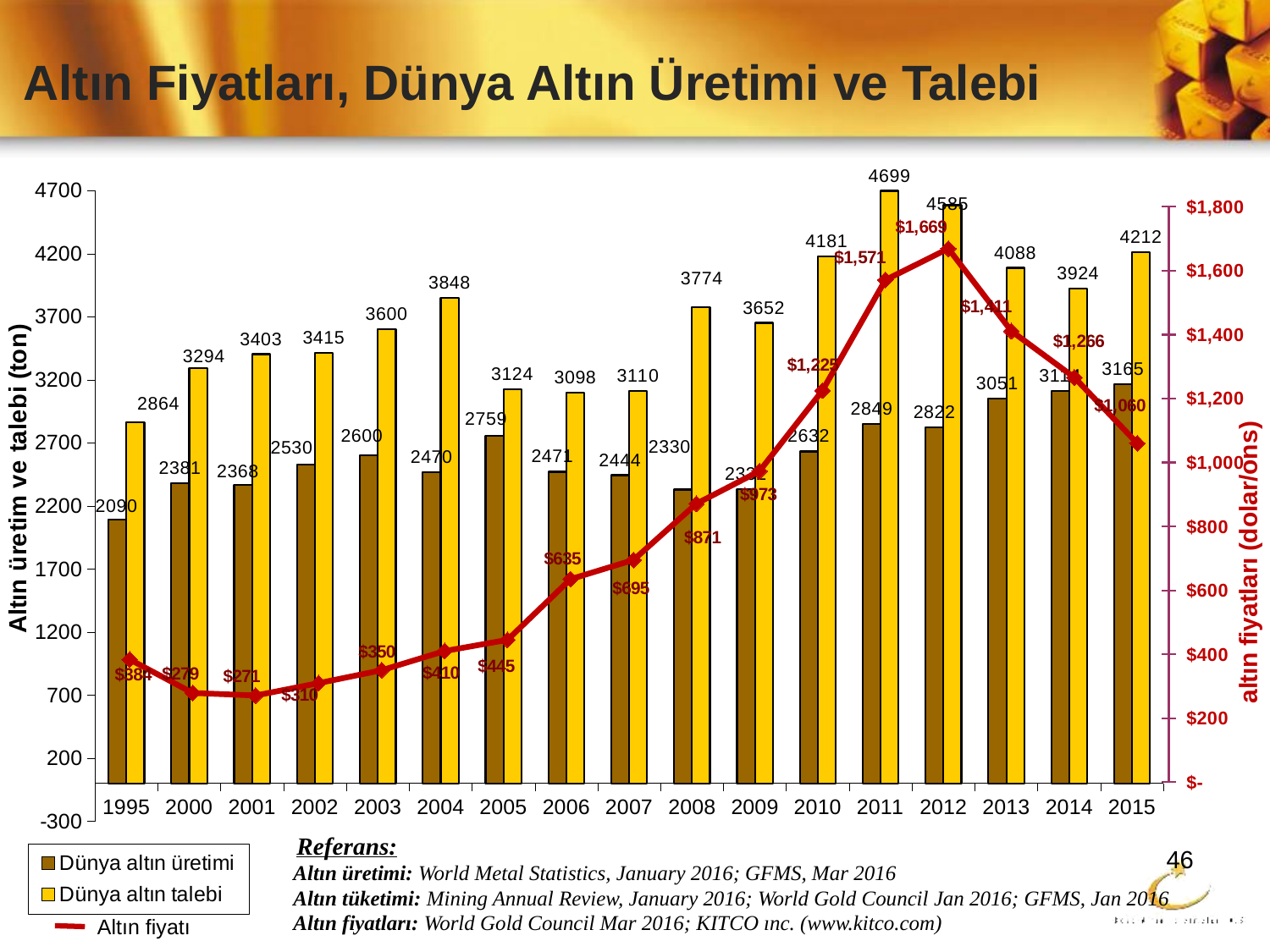
Did the gold price rise or fall from 2012 to 2015? Fall What is the difference between world gold demand and world gold production in 2015? 1047 Which was higher in 2004: world gold demand or world gold production? World gold demand (Dünya altın talebi) In which year was world gold demand highest? 2011 What was world gold production (Dünya altın üretimi) in 1995? 2090 How many years are shown on the x axis? 17 Is the gold price in 2010 greater or less than $1,200? greater What was the gold price (Altın fiyatı) in 2012? $1,669 In which year was the gold price lowest? 2001 How many series does the legend list? 3 What was world gold demand (Dünya altın talebi) in 2011? 4699 What kind of chart is used for the gold price series? Line chart